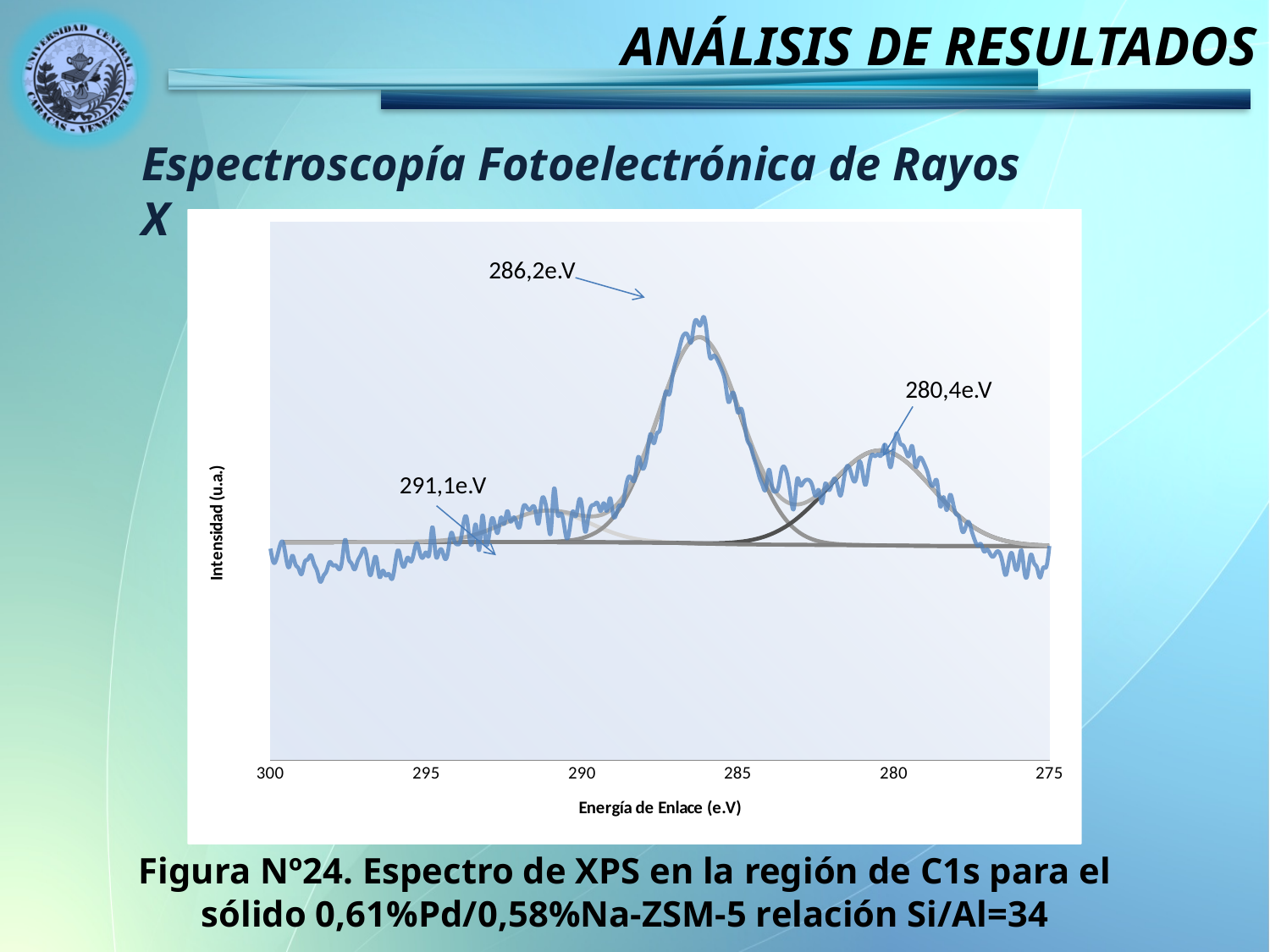
Which labeled peak has a higher intensity, the one at 291,1e.V or the one at 280,4e.V? 280,4e.V What is the binding energy labeled on the peak located between 285 and 275 e.V on the x axis? 280,4e.V How many peaks are labeled with a binding energy value on the chart? 3 What is the difference in binding energy between the peaks labeled 286,2e.V and 280,4e.V? 5,8 e.V Which labeled peak has a higher intensity, the one at 286,2e.V or the one at 280,4e.V? 286,2e.V What is the label of the y axis of the chart? Intensidad (u.a.) What binding energy is labeled on the tallest peak of the spectrum? 286,2e.V Which labeled peak has the lowest intensity? 291,1e.V What is the label of the x axis of the chart? Energía de Enlace (e.V) How many tick labels are shown on the x axis of the chart? 6 What is the difference in binding energy between the peaks labeled 291,1e.V and 286,2e.V? 4,9 e.V What kind of chart is shown on the slide? line chart